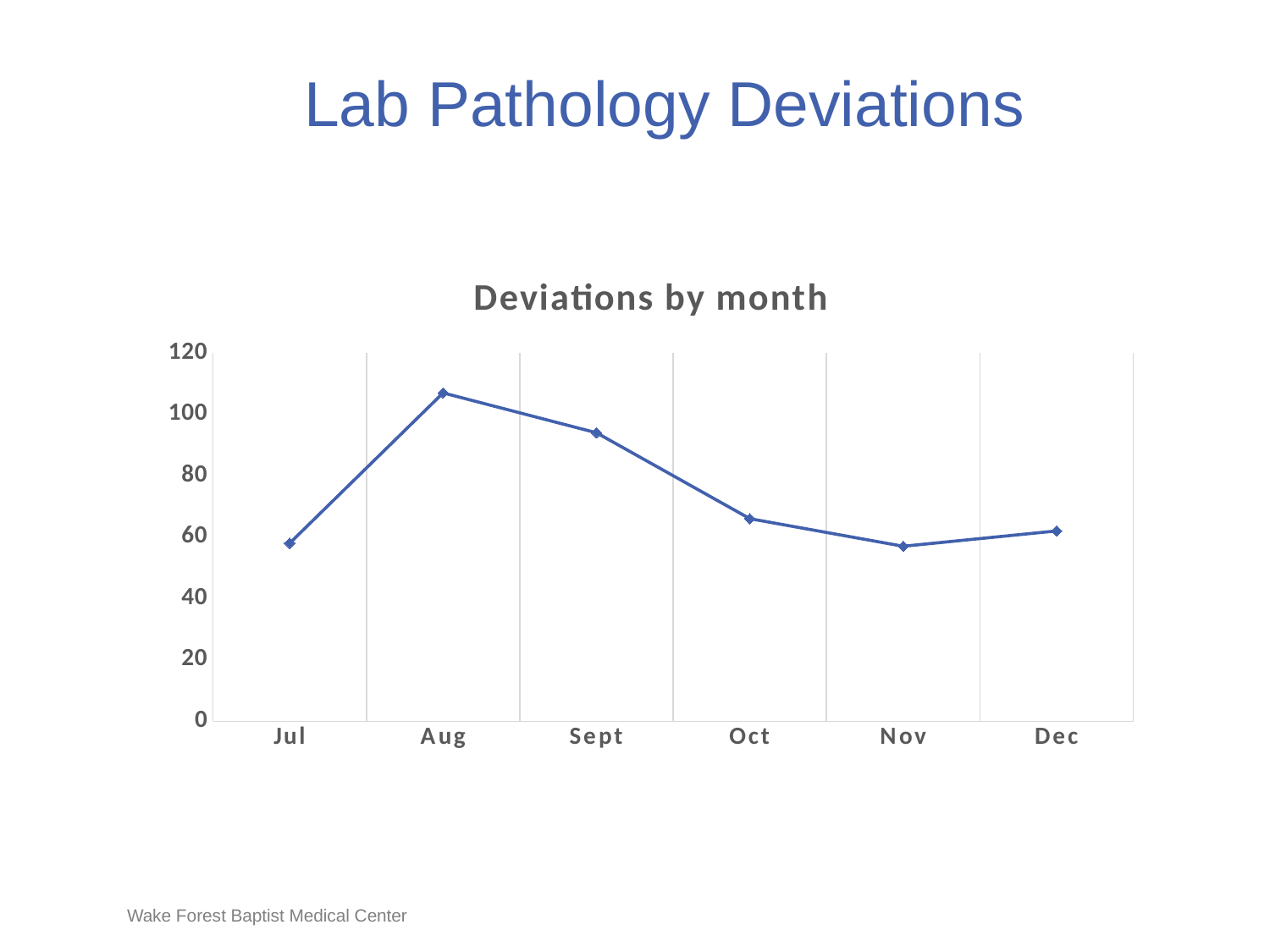
What is the title of the chart? Deviations by month How many months are plotted on the x axis? 6 Is the value for Sept greater or less than 80? greater Which is larger, the value for Aug or the value for Sept? Aug Do the values rise or fall from Aug to Nov? fall Is the value for Jul greater or less than 80? less Which is larger, the value for Oct or the value for Jul? Oct Is the value for Aug greater or less than 100? greater Which month has the highest number of deviations? Aug What kind of chart is shown on the slide? line chart